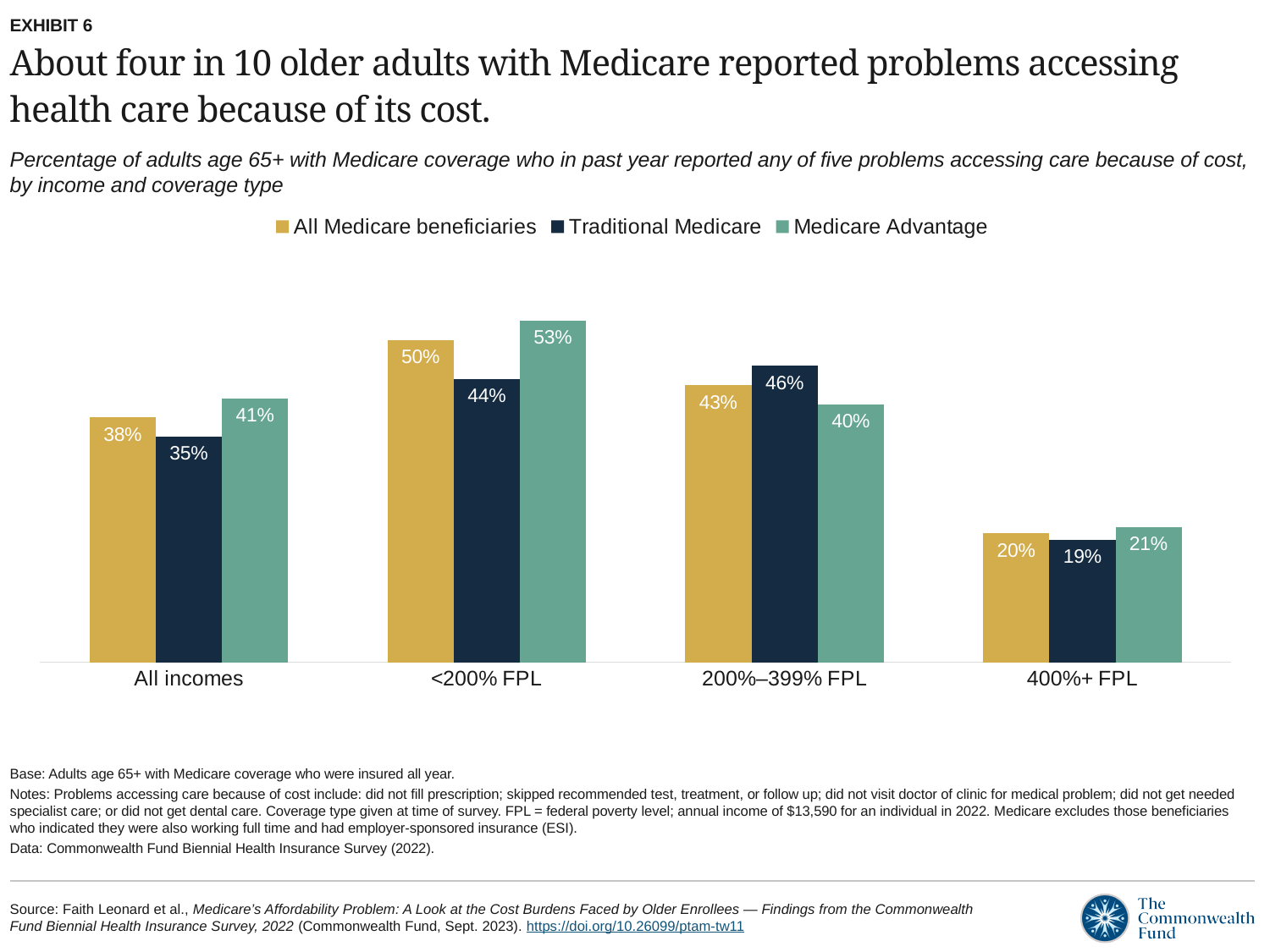
What is the value for All Medicare beneficiaries in the 200%–399% FPL group? 43% What is the value for Traditional Medicare in the All incomes group? 35% In the 200%–399% FPL group, which is larger: Traditional Medicare or Medicare Advantage? Traditional Medicare How many series does the legend list? 3 Which income group has the lowest value for Medicare Advantage? 400%+ FPL What percentage of Medicare Advantage beneficiaries with income <200% FPL reported problems accessing care because of cost? 53% Which income group has the highest value for Traditional Medicare? 200%–399% FPL Do the values for All Medicare beneficiaries rise or fall from <200% FPL to 400%+ FPL? Fall What kind of chart is shown on the slide? Bar chart What is the difference between the Medicare Advantage and Traditional Medicare values in the <200% FPL group? 9 percentage points How many income groups are shown on the x axis? 4 Which colour represents Medicare Advantage in the legend? Green